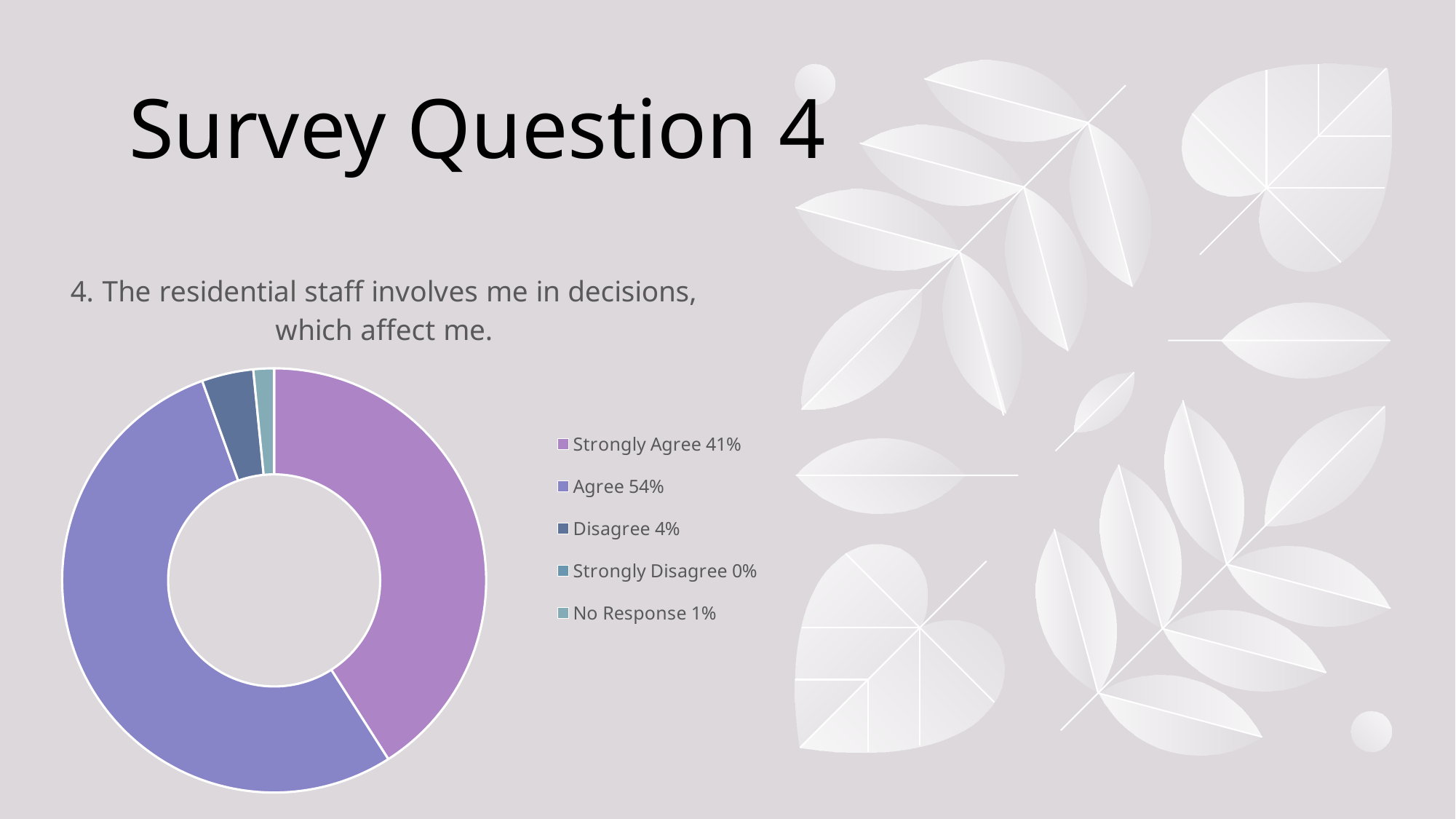
Which response category has the smallest share? Strongly Disagree What is the difference in percentage points between Agree and Strongly Agree? 13 What survey statement does the chart relate to? The residential staff involves me in decisions, which affect me. What kind of chart is shown on the slide? Doughnut (pie) chart Which is larger, the share for Disagree or the share for No Response? Disagree What is the combined percentage for Strongly Agree and Agree? 95% What percentage of respondents answered Disagree? 4% How many response categories does the legend list? 5 What percentage of respondents answered Strongly Agree? 41% What percentage of respondents gave No Response? 1% Which response category has the largest share? Agree What percentage of respondents answered Agree? 54%